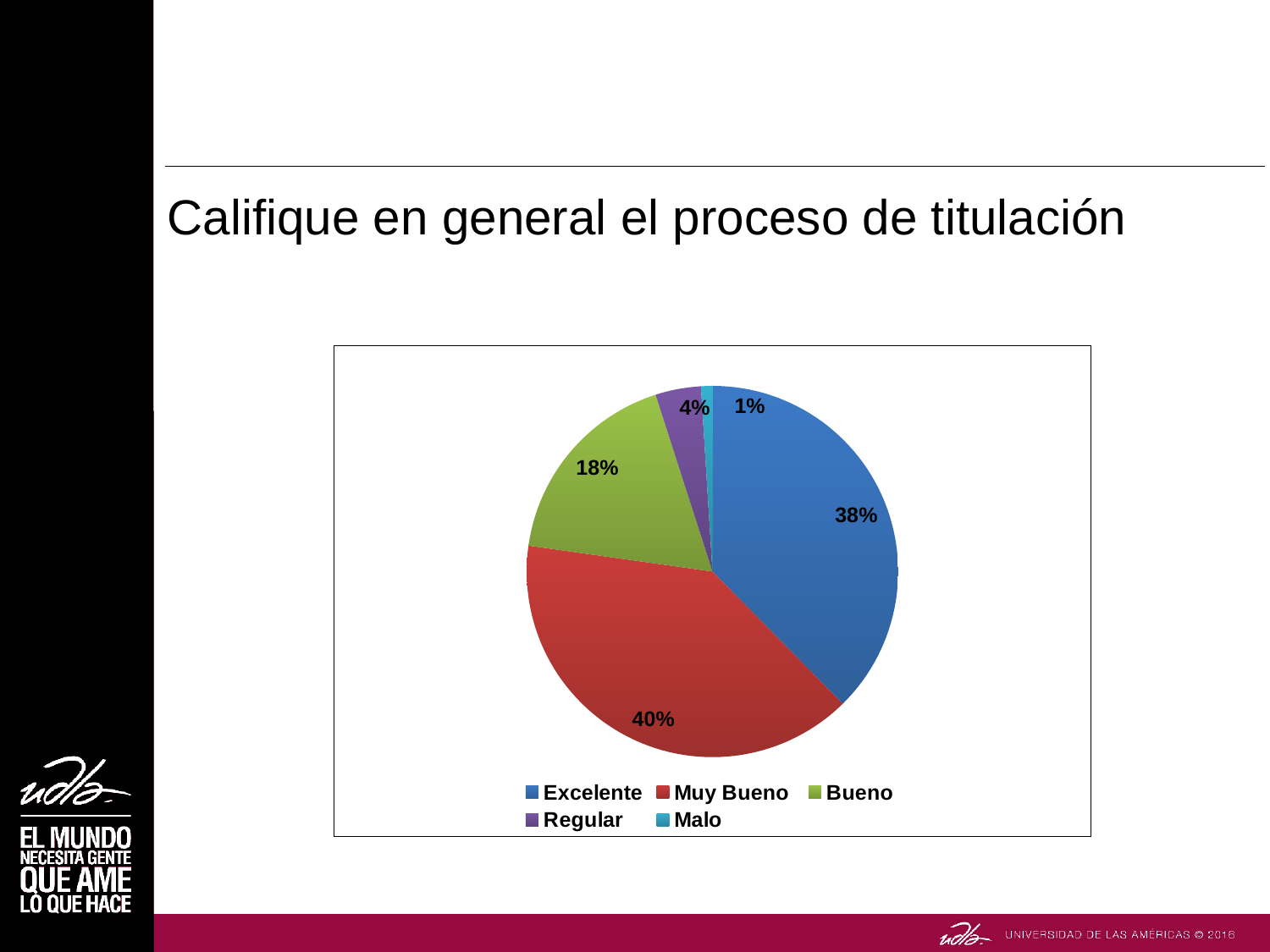
What percentage of respondents rated the process as Excelente? 38% What percentage of respondents rated the process as Muy Bueno? 40% What is the difference in percentage points between Muy Bueno and Excelente? 2 What kind of chart is shown on the slide? Pie chart What percentage of respondents rated the process as Bueno? 18% Which is larger, the share for Bueno or the share for Regular? Bueno What percentage of respondents rated the process as Regular? 4% How many categories does the legend list? 5 What is the difference in percentage points between Bueno and Regular? 14 What percentage of respondents rated the process as Malo? 1% Which rating category has the largest share of the pie? Muy Bueno Which rating category has the smallest share of the pie? Malo